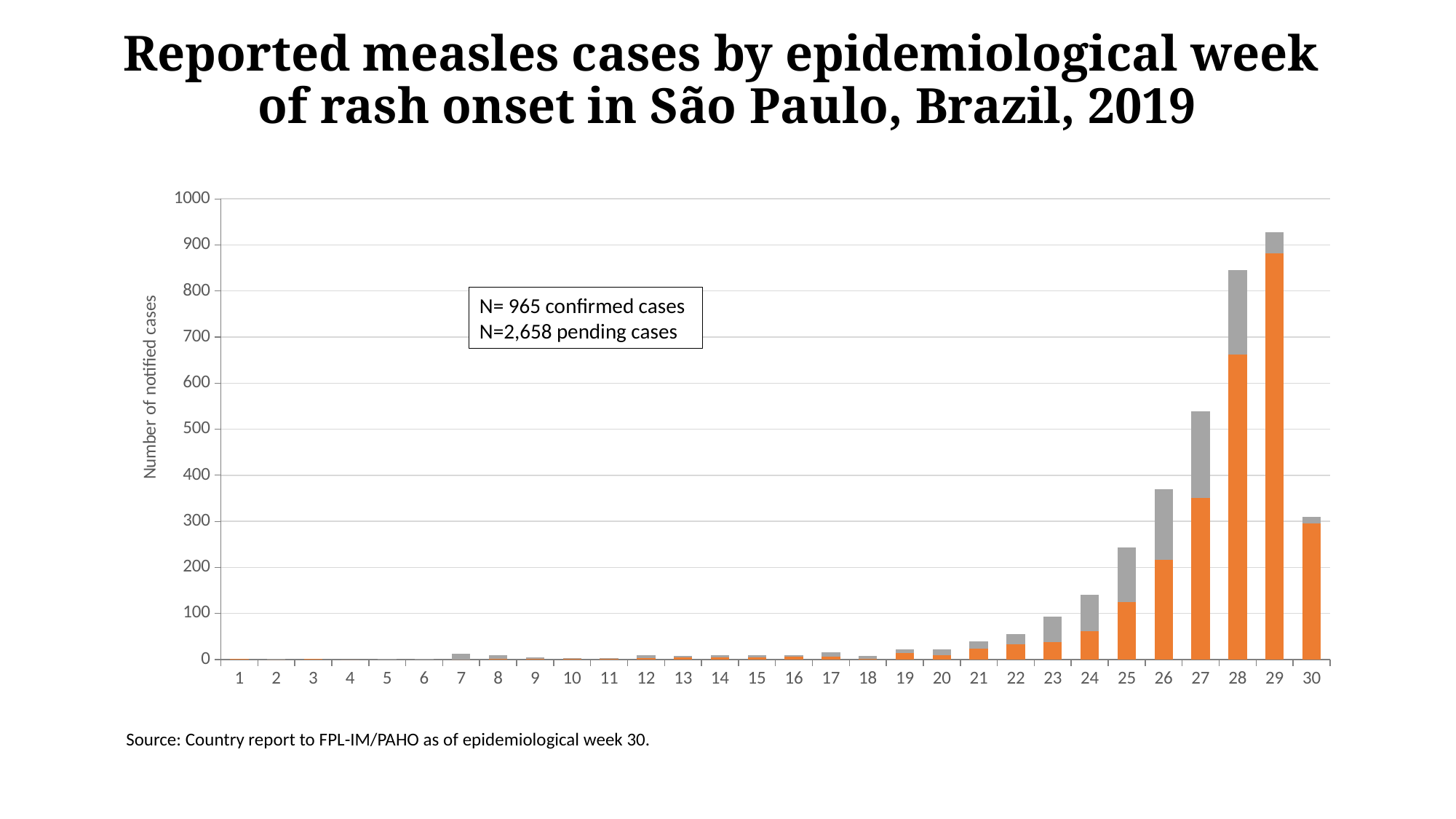
Is the total bar height for week 28 greater or less than 800? greater Do the bar heights generally rise or fall from week 20 to week 29? Rise What is the label on the y axis of the chart? Number of notified cases Which bar is taller, week 28 or week 30? Week 28 Which epidemiological week has the tallest bar in the chart? 29 How many epidemiological weeks are shown on the x axis of the chart? 30 Is the total bar height for week 27 greater or less than 500? greater Is the total bar height for week 26 greater or less than 400? less What kind of chart is shown on the slide? Stacked bar chart According to the text box on the chart, how many pending cases are there? 2,658